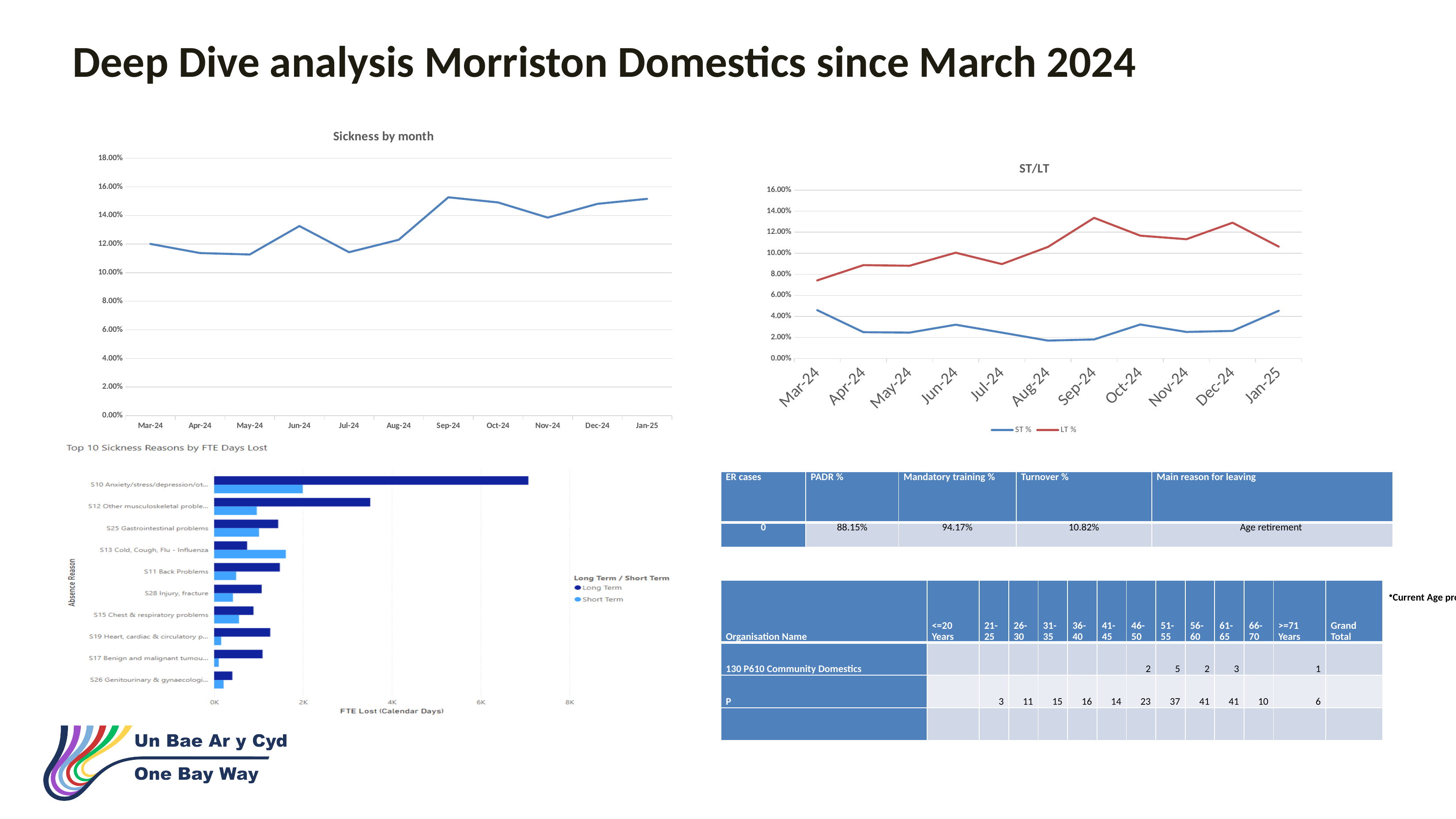
In the 'Sickness by month' chart, do values overall rise or fall from Mar-24 to Jan-25? rise In the 'ST/LT' chart, is the LT % value for Mar-24 greater or less than 8.00%? less In the 'ST/LT' chart, which month has the lowest LT % value? Mar-24 In the 'Sickness by month' chart, is the value for Sep-24 greater or less than 14.00%? greater What kind of chart is 'Top 10 Sickness Reasons by FTE Days Lost'? bar chart In the 'Top 10 Sickness Reasons by FTE Days Lost' chart, is the Long Term value for S12 Other musculoskeletal problems greater or less than 4K? less In the 'ST/LT' chart, which is larger in Sep-24, ST % or LT %? LT % How many series does the legend of the 'ST/LT' chart list? 2 What kind of chart is the 'Sickness by month' chart? line chart In the 'Top 10 Sickness Reasons by FTE Days Lost' chart, which absence reason has the highest Long Term value? S10 Anxiety/stress/depression In the 'Sickness by month' chart, how many months are plotted? 11